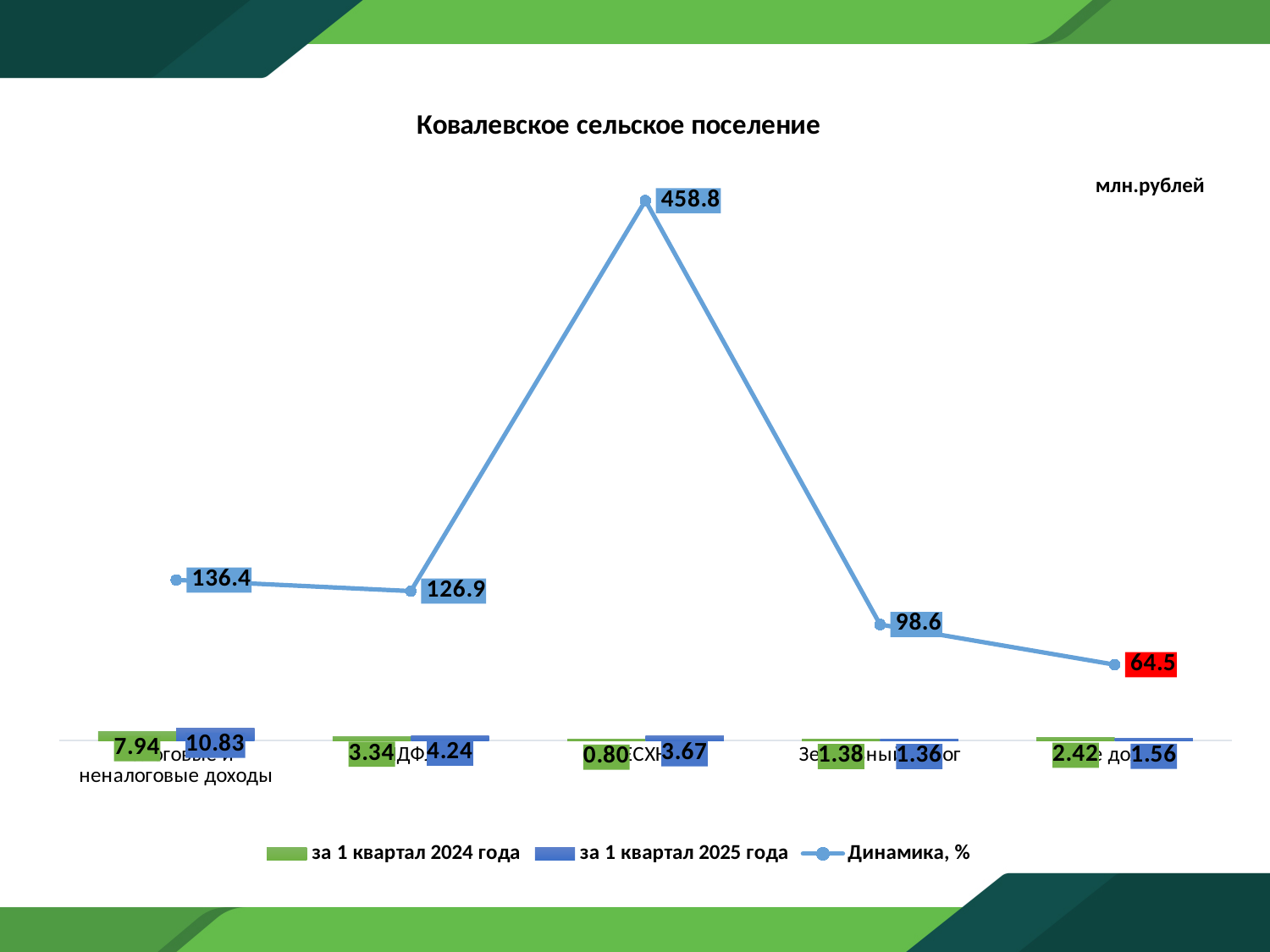
What is the title of the chart? Ковалевское сельское поселение How many categories are plotted along the x axis? 5 Which category has the highest 'Динамика, %' value? The third category from the left (458.8) What is the value for 'за 1 квартал 2025 года' for the first category (Налоговые и неналоговые доходы)? 10.83 What is the value for 'за 1 квартал 2024 года' for the first category (Налоговые и неналоговые доходы)? 7.94 What is the value of 'Динамика, %' for the third category from the left? 458.8 How many series does the legend list? 3 What is the difference between the 2025 and 2024 values for the first category (Налоговые и неналоговые доходы)? 2.89 What is the lowest 'Динамика, %' value shown on the line? 64.5 What is the value of 'Динамика, %' for the rightmost category? 64.5 What kind of chart is this? Combined bar and line chart For the third category from the left, which is larger: the value for 'за 1 квартал 2024 года' or 'за 1 квартал 2025 года'? за 1 квартал 2025 года